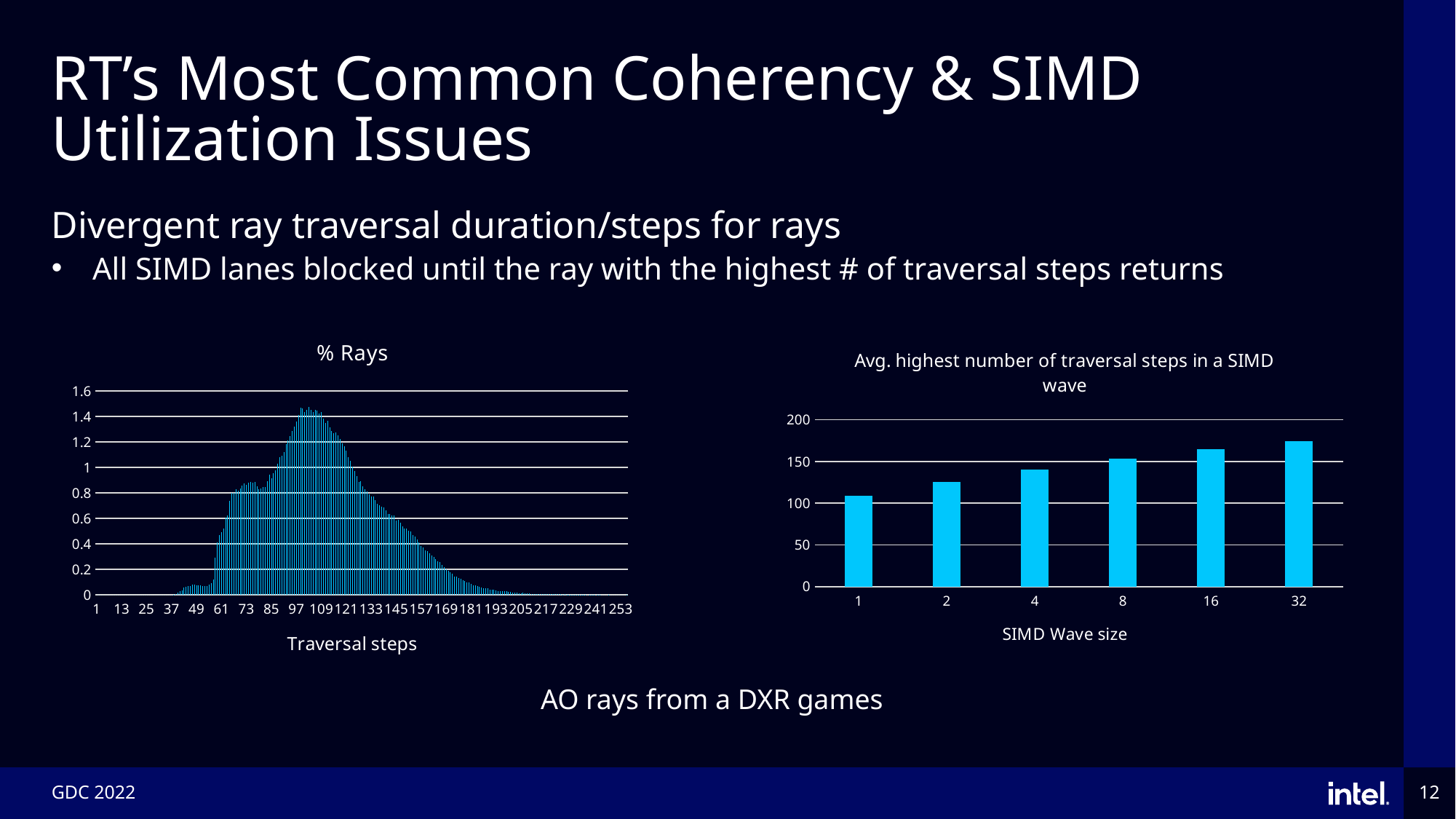
In the right chart, which SIMD wave size has the lowest average number of traversal steps? 1 In the right chart, is the value for SIMD wave size 32 greater or less than 200? less In the right chart, which is larger: the value for SIMD wave size 2 or the value for SIMD wave size 16? 16 In the right chart, is the value for SIMD wave size 16 greater or less than 150? greater In the right chart, is the value for SIMD wave size 1 greater or less than 100? greater What is the x-axis title of the left '% Rays' chart? Traversal steps In the right chart, do the values rise or fall as the SIMD wave size increases along the x axis? rise What kind of chart is the 'Avg. highest number of traversal steps in a SIMD wave' chart on the right? bar chart What is the x-axis title of the right chart? SIMD Wave size In the right chart, which SIMD wave size has the highest average number of traversal steps? 32 In the right chart, how many SIMD wave sizes are plotted on the x axis? 6